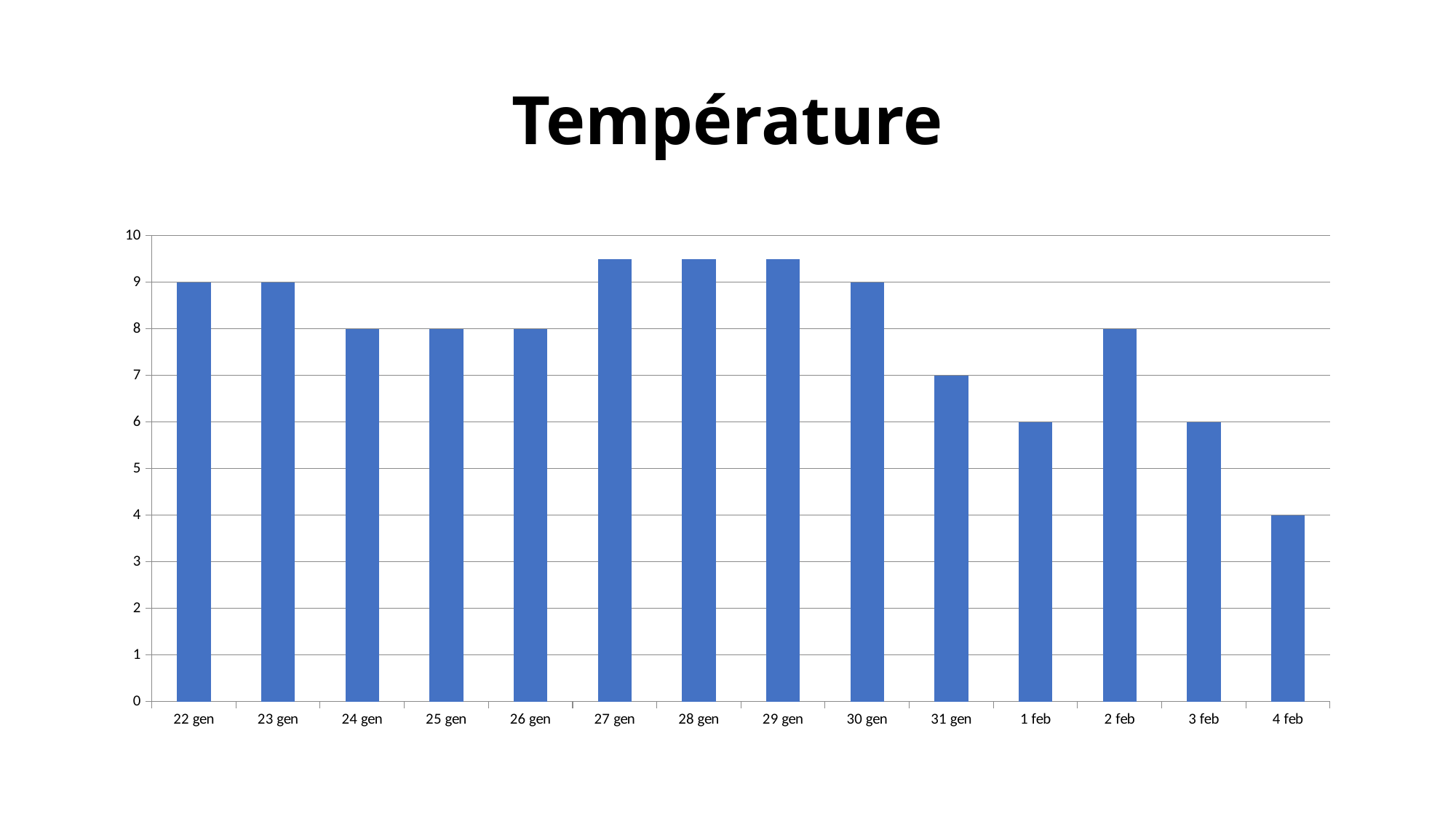
What is the value for 22 gen? 9 How many categories are shown on the x axis? 14 Which category has the lowest value? 4 feb What is the value for 4 feb? 4 What is the value for 2 feb? 8 What is the difference between the values for 22 gen and 4 feb? 5 Which is larger, the value for 31 gen or the value for 2 feb? 2 feb What kind of chart is shown on the slide? bar chart What is the title of the chart? Température What is the value for 31 gen? 7 Is the value for 27 gen greater or less than 9? greater Do the values rise or fall from 29 gen to 1 feb? fall